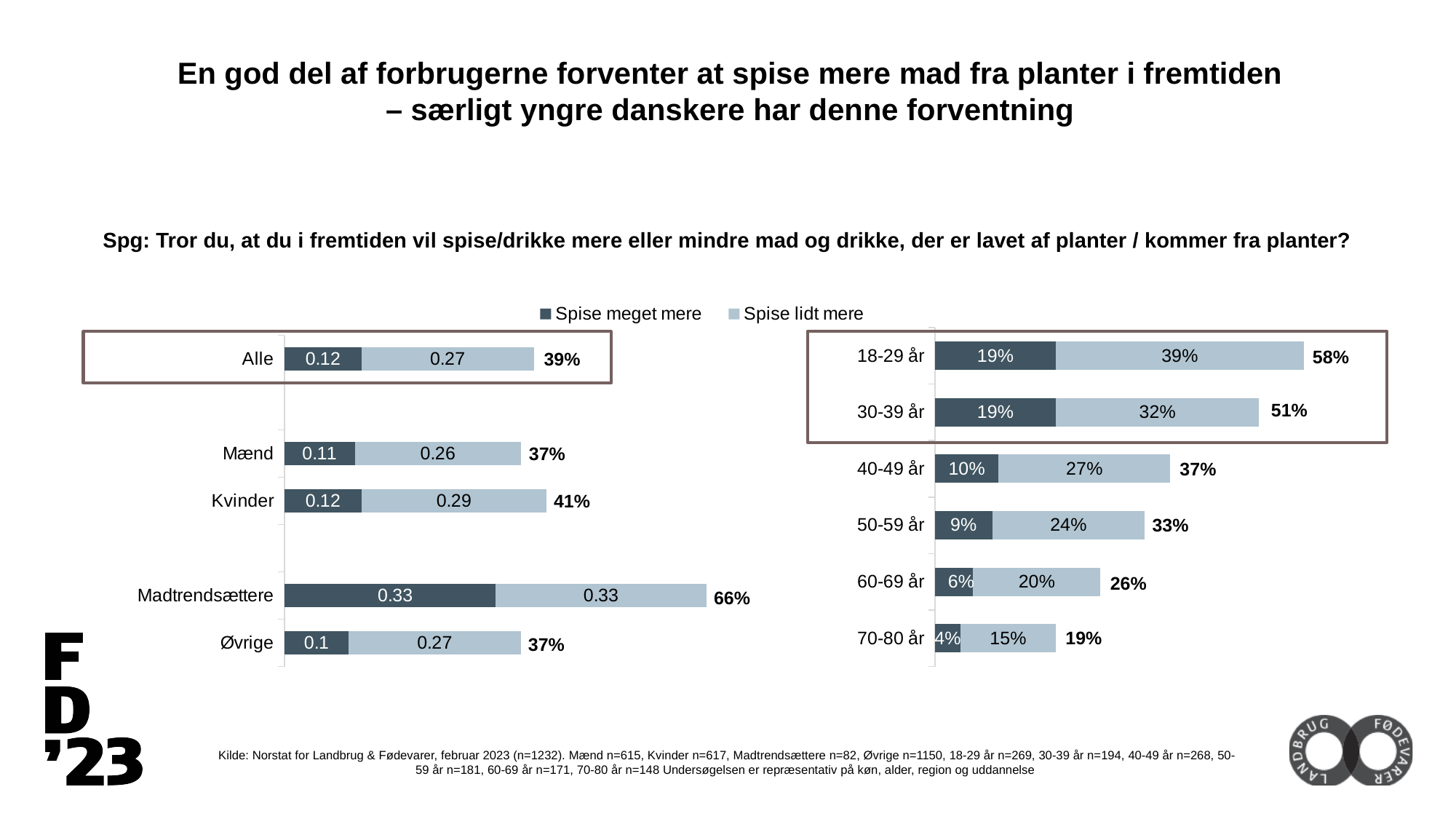
In the right chart, do the totals rise or fall as the age groups get older? Fall In the right chart, what is the total shown for the 30-39 år bar? 51% In the left chart, which category has the highest total? Madtrendsættere In the right chart, what is the 'Spise lidt mere' value for 18-29 år? 39% In the left chart, which has the larger total, Mænd or Kvinder? Kvinder In the right chart, what is the difference between the totals for 18-29 år and 70-80 år? 39% In the left chart, what is the 'Spise lidt mere' value for Øvrige? 0.27 In the right chart, which age group has the lowest total? 70-80 år How many age groups are shown in the right chart? 6 What kind of chart is used on the slide? Stacked bar chart How many series does the legend list? 2 In the left chart, what is the 'Spise meget mere' value for Madtrendsættere? 0.33